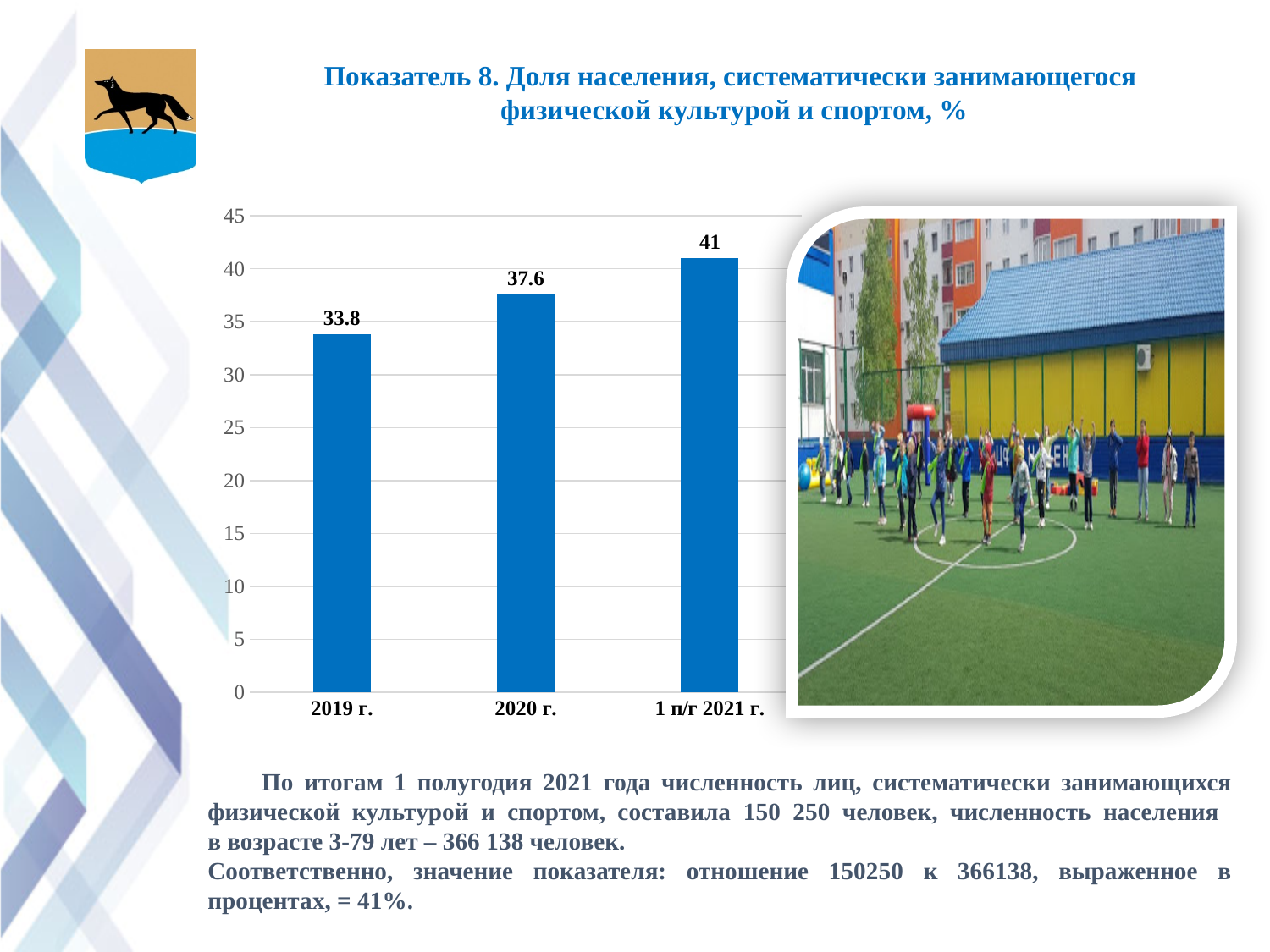
How many categories are shown on the x axis? 3 What is the difference between the values for 2020 г. and 2019 г.? 3.8 Which category has the highest value? 1 п/г 2021 г. What is the value for 1 п/г 2021 г.? 41 Which category has the lowest value? 2019 г. Which is larger, the value for 2019 г. or the value for 2020 г.? 2020 г. Is the value for 1 п/г 2021 г. greater or less than 40? greater What kind of chart is shown on the slide? bar chart What is the value for 2019 г.? 33.8 Do the values rise or fall from 2019 г. to 1 п/г 2021 г.? rise What is the value for 2020 г.? 37.6 What is the difference between the values for 1 п/г 2021 г. and 2020 г.? 3.4